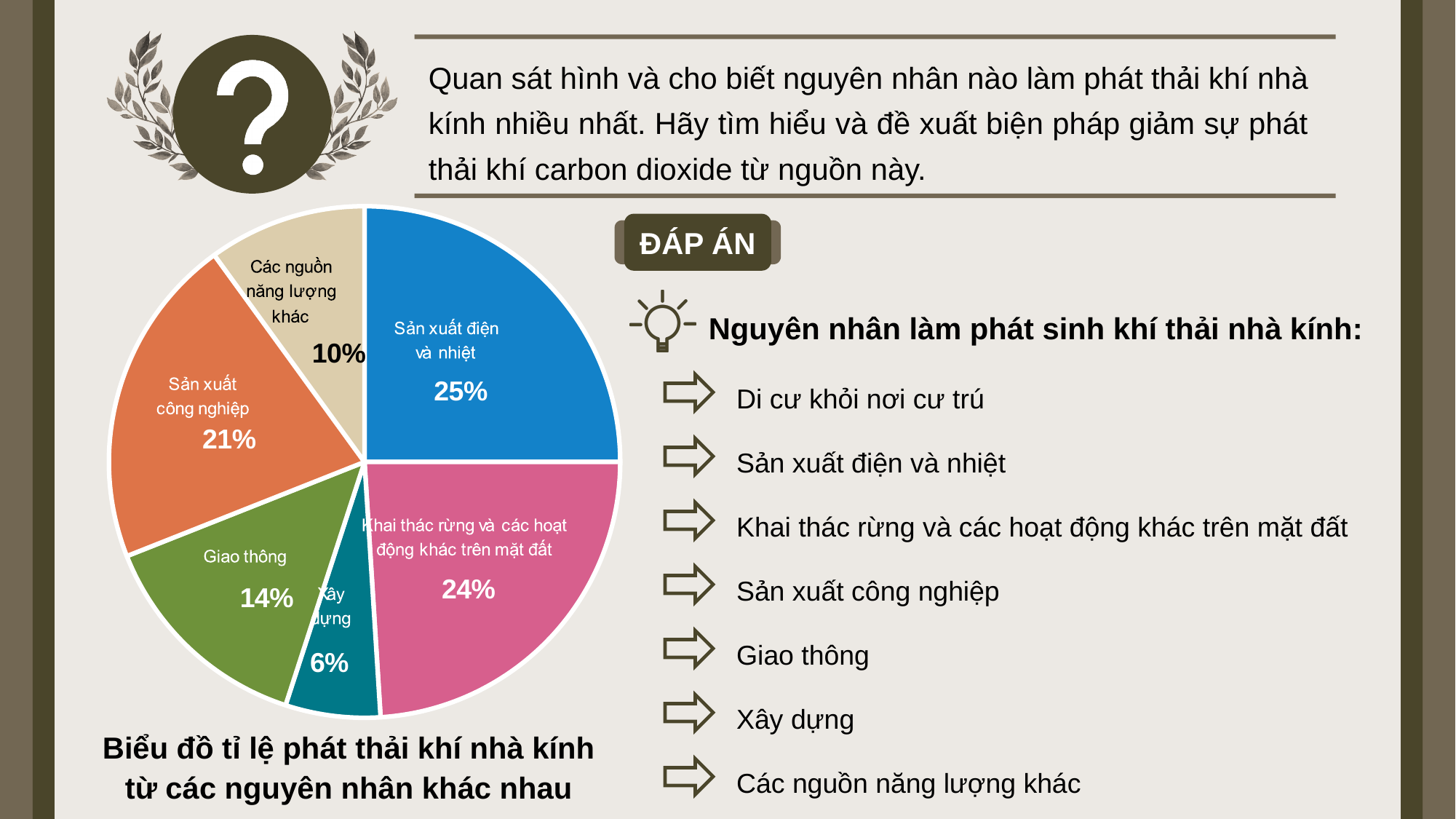
Which category has the largest slice in the pie chart? Sản xuất điện và nhiệt What share does "Xây dựng" have in the pie chart? 6% What kind of chart is shown on the slide? Pie chart What percentage is shown for "Sản xuất công nghiệp"? 21% What colour is the "Giao thông" slice in the pie chart? Green What percentage of greenhouse gas emissions does the chart attribute to "Sản xuất điện và nhiệt"? 25% What is the difference between the shares of "Sản xuất công nghiệp" and "Giao thông"? 7% Which is larger: the share for "Khai thác rừng và các hoạt động khác trên mặt đất" or the share for "Sản xuất công nghiệp"? Khai thác rừng và các hoạt động khác trên mặt đất What is the value shown for "Giao thông" in the pie chart? 14% Which category has the smallest slice in the pie chart? Xây dựng What value is labelled on the "Các nguồn năng lượng khác" slice? 10% How many categories are shown in the pie chart? 6